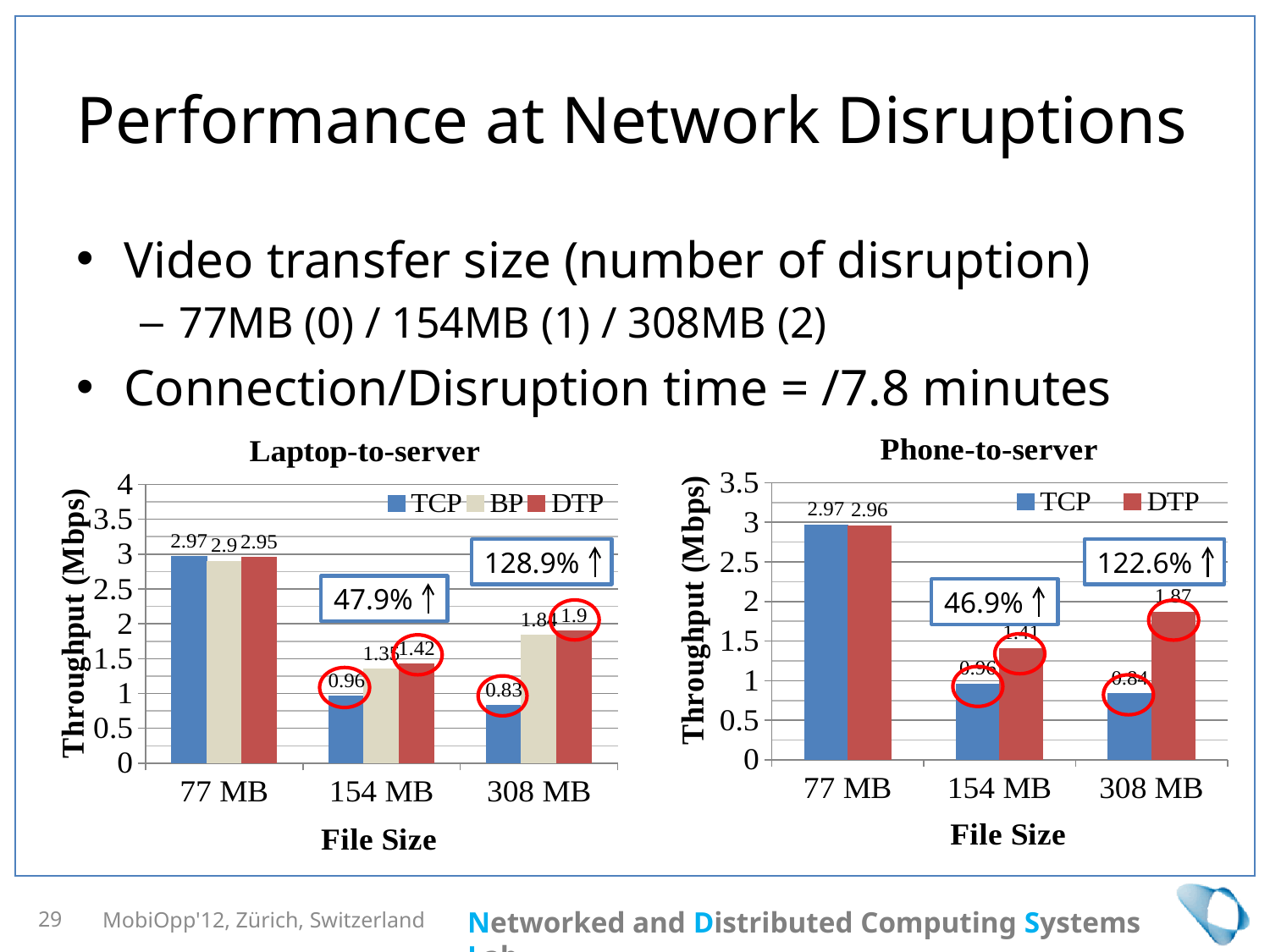
How many series does the legend of the Laptop-to-server chart list? 3 In the Laptop-to-server chart, what is the DTP throughput for the 308 MB file? 1.9 In the Laptop-to-server chart, what is the difference between the DTP and TCP throughput for the 308 MB file? 1.07 How many file size categories are shown on the x axis of the Phone-to-server chart? 3 In the Laptop-to-server chart, what is the BP throughput for the 154 MB file? 1.35 In the Laptop-to-server chart, which file size has the lowest TCP throughput? 308 MB In the Laptop-to-server chart, for the 154 MB file, which is larger: the TCP or the DTP throughput? DTP In the Laptop-to-server chart, what is the TCP throughput for the 77 MB file? 2.97 In the Phone-to-server chart, what is the TCP throughput for the 77 MB file? 2.97 In the Phone-to-server chart, is the TCP throughput for the 308 MB file greater or less than 1? less In the Phone-to-server chart, what is the DTP throughput for the 308 MB file? 1.87 What type of chart is the Phone-to-server chart? Bar chart